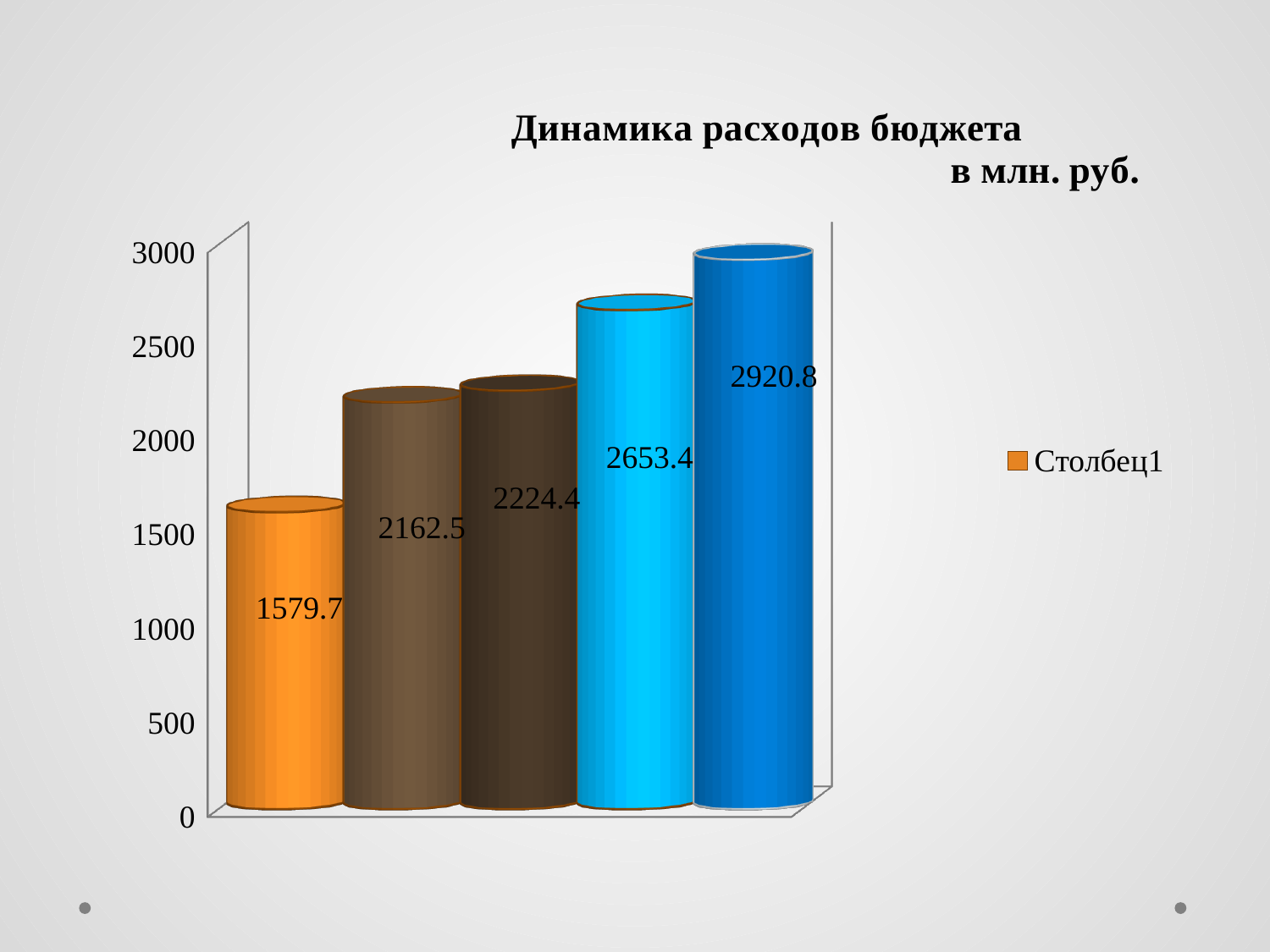
What is the difference between the second bar (2162.5) and the third bar (2224.4)? 61.9 What is the value shown on the last (dark blue) bar on the right? 2920.8 What is the difference between the highest value (2920.8) and the lowest value (1579.7)? 1341.1 What is the value shown on the third bar from the left? 2224.4 Which bar has the highest value? The last (dark blue) bar, 2920.8 Do the values rise or fall from left to right across the bars? Rise How many bars are plotted in the chart? 5 Which bar has the lowest value? The first (orange) bar, 1579.7 What is the value shown on the first (orange) bar? 1579.7 What is the title of the chart? Динамика расходов бюджета в млн. руб. What is the value shown on the light blue bar? 2653.4 Which is larger, the value of the light blue bar or the value of the orange bar? The light blue bar (2653.4)